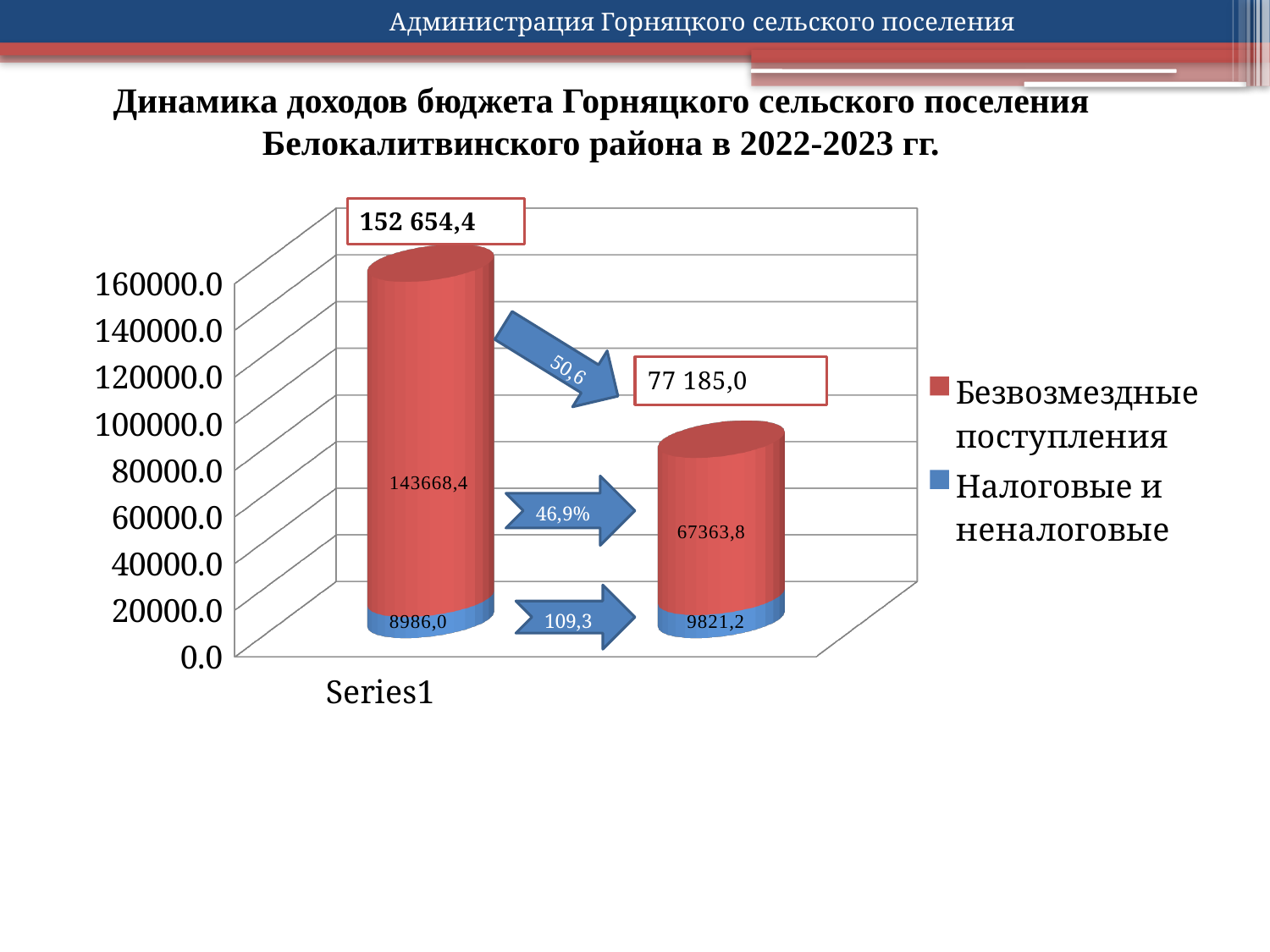
What is the total of the left stacked bar? 152 654,4 How many series does the legend list? 2 What is the value of Налоговые и неналоговые in the left bar? 8986,0 Which bar has the larger value for Безвозмездные поступления, the left or the right? Left What is the total of the right stacked bar? 77 185,0 What kind of chart is shown on the slide? Stacked bar chart What is the value of Безвозмездные поступления in the left bar? 143668,4 Which colour represents Безвозмездные поступления in the legend? Red How many bars are plotted in the chart? 2 What is the value of Безвозмездные поступления in the right bar? 67363,8 What is the value of Налоговые и неналоговые in the right bar? 9821,2 What is the difference between the Безвозмездные поступления values of the left and right bars? 76304,6